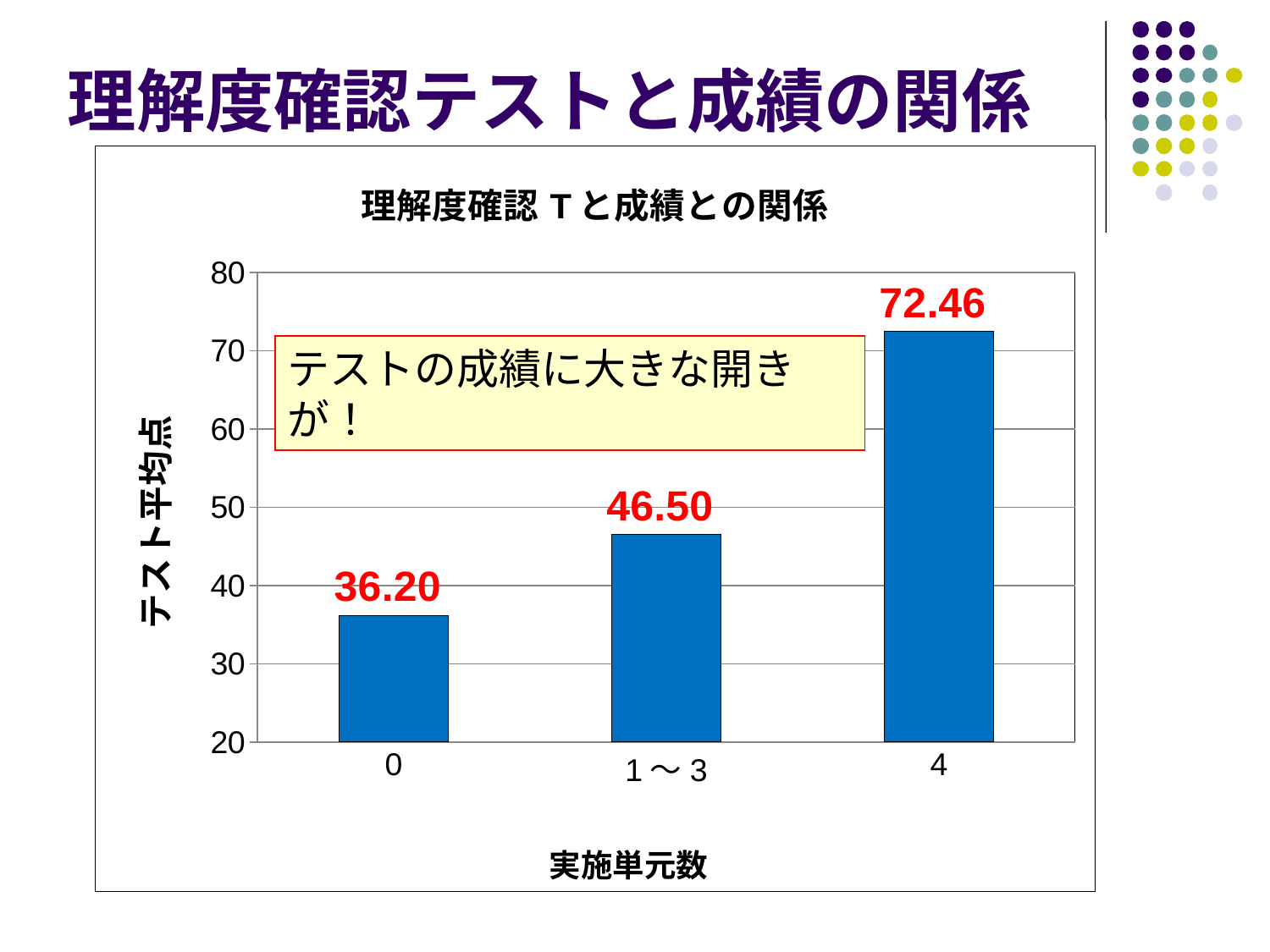
Which category has the highest average test score? 4 What is the difference between the average test score for category 1～3 and category 0? 10.30 Is the value for category 1～3 greater or less than 50? less Which category has the lowest average test score? 0 What is the difference between the average test score for category 4 and category 0? 36.26 Do the values rise or fall as the number of implemented units (実施単元数) increases along the x axis? rise Which is larger, the average test score for category 1～3 or for category 4? 4 What is the average test score for the category 1～3? 46.50 What is the average test score for the category 4? 72.46 How many categories are shown on the x axis? 3 What kind of chart is shown on the slide? bar chart What is the average test score (テスト平均点) for the category 0 (実施単元数)? 36.20